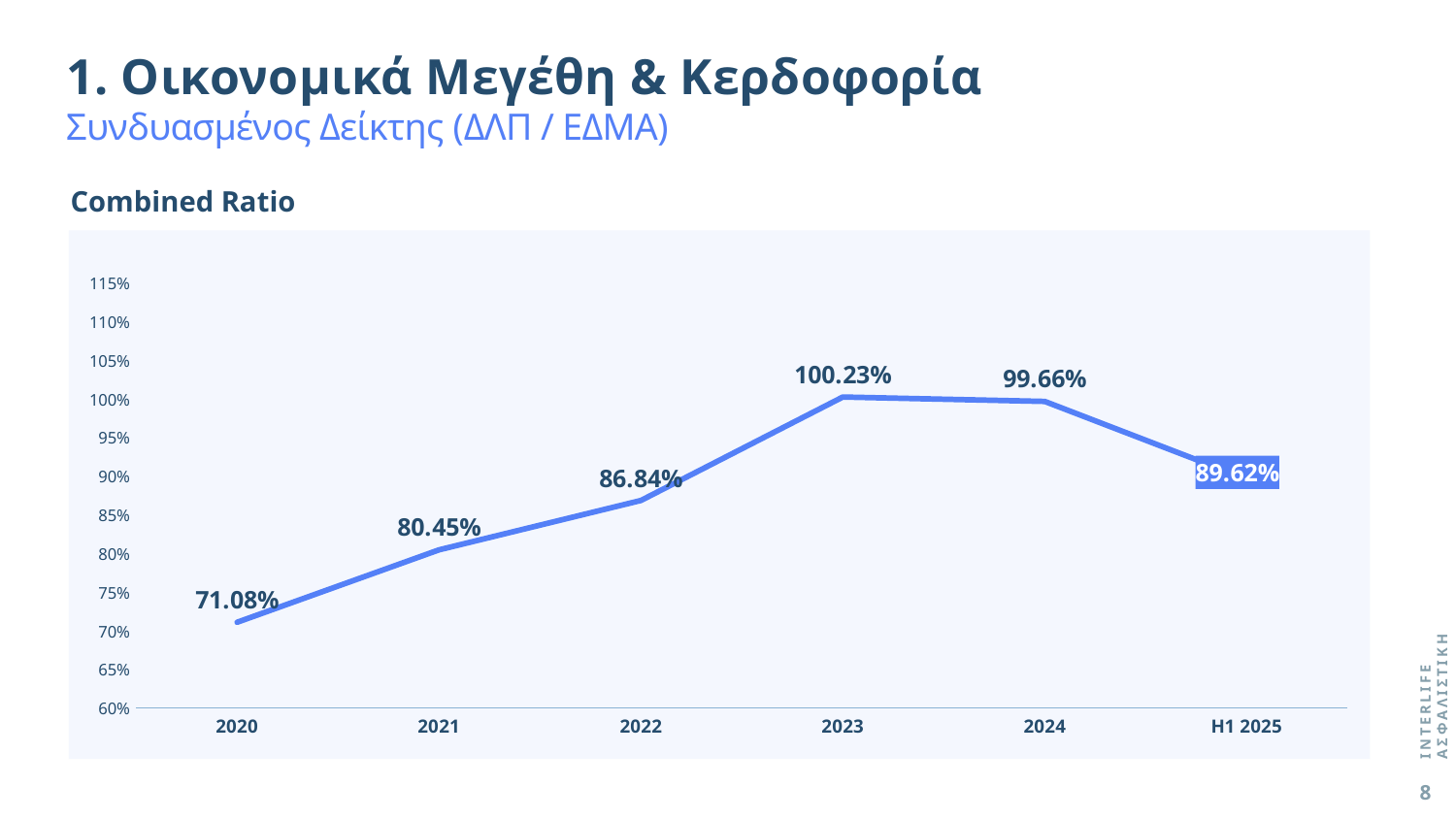
How many time periods are plotted on the Combined Ratio chart? 6 Does the Combined Ratio rise or fall from 2020 to 2023? rise What is the Combined Ratio for H1 2025? 89.62% What is the Combined Ratio for 2023? 100.23% What is the Combined Ratio for 2020? 71.08% What is the difference between the Combined Ratio in 2021 and in 2020? 9.37% What is the difference between the Combined Ratio in 2023 and in 2024? 0.57% What kind of chart is used to show the Combined Ratio? line chart Which year has the highest Combined Ratio? 2023 Which is larger, the Combined Ratio for 2022 or for H1 2025? H1 2025 Is the Combined Ratio for 2024 greater or less than 95%? greater Which year has the lowest Combined Ratio? 2020